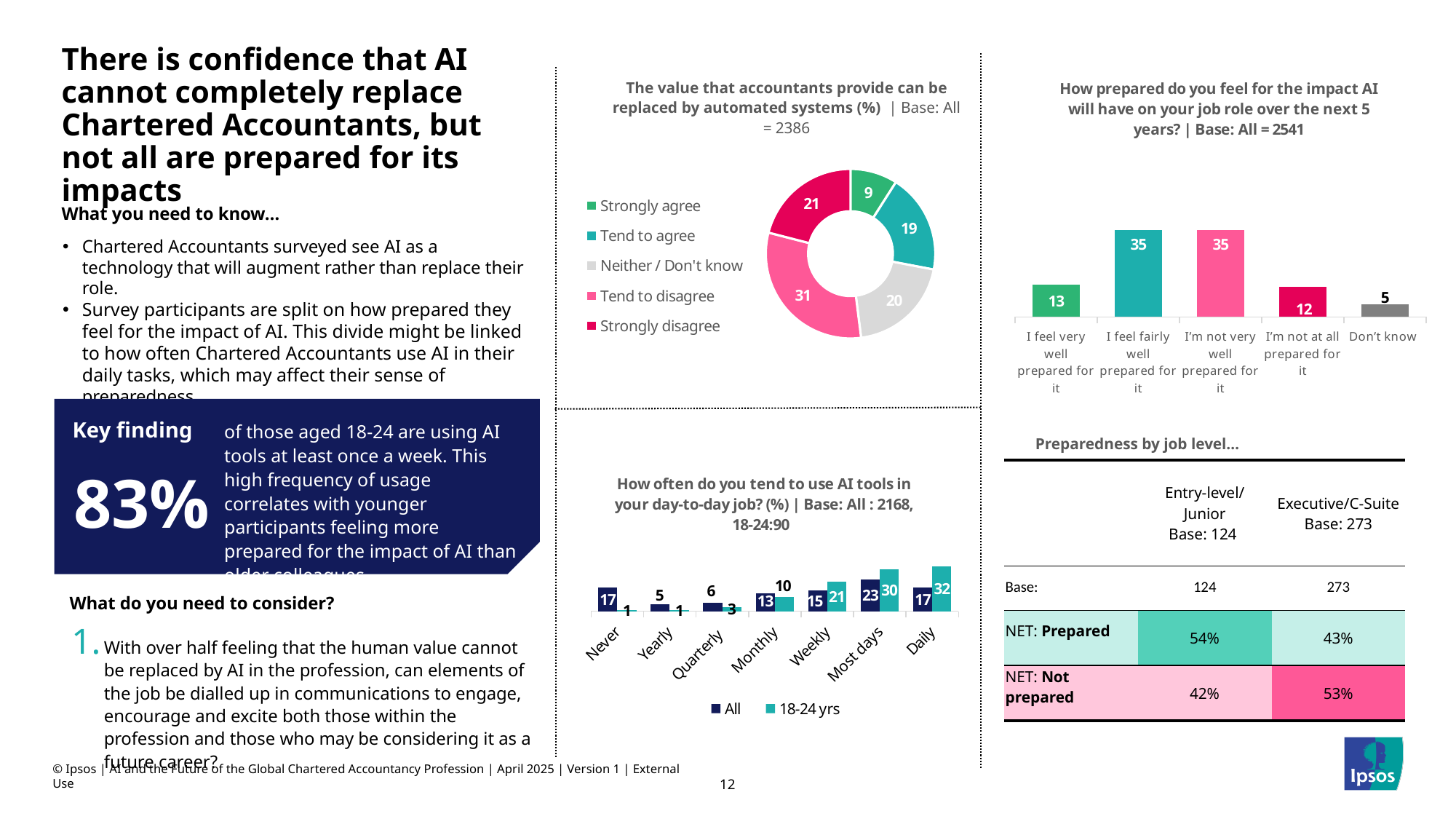
In the chart 'How prepared do you feel for the impact AI will have on your job role over the next 5 years?', what is the value for 'I feel very well prepared for it'? 13 In the chart 'How prepared do you feel for the impact AI will have on your job role over the next 5 years?', how many categories are shown on the x axis? 5 In the donut chart 'The value that accountants provide can be replaced by automated systems', which response has the smallest share? Strongly agree In the donut chart 'The value that accountants provide can be replaced by automated systems', what percentage is shown for 'Tend to disagree'? 31 In the chart 'How often do you tend to use AI tools in your day-to-day job?', what is the value for 'Daily' among 18-24 yrs? 32 In the chart 'How prepared do you feel for the impact AI will have on your job role over the next 5 years?', which category has the lowest value? Don't know In the donut chart 'The value that accountants provide can be replaced by automated systems', how many response categories does the legend list? 5 In the chart 'How often do you tend to use AI tools in your day-to-day job?', how many series does the legend list? 2 In the chart 'How often do you tend to use AI tools in your day-to-day job?', what is the difference between 18-24 yrs and All for 'Most days'? 7 In the donut chart 'The value that accountants provide can be replaced by automated systems', what is the difference between 'Strongly disagree' and 'Tend to agree'? 2 What type of chart is used for 'The value that accountants provide can be replaced by automated systems'? Donut chart In the chart 'How often do you tend to use AI tools in your day-to-day job?', which is larger for 'Never': All or 18-24 yrs? All